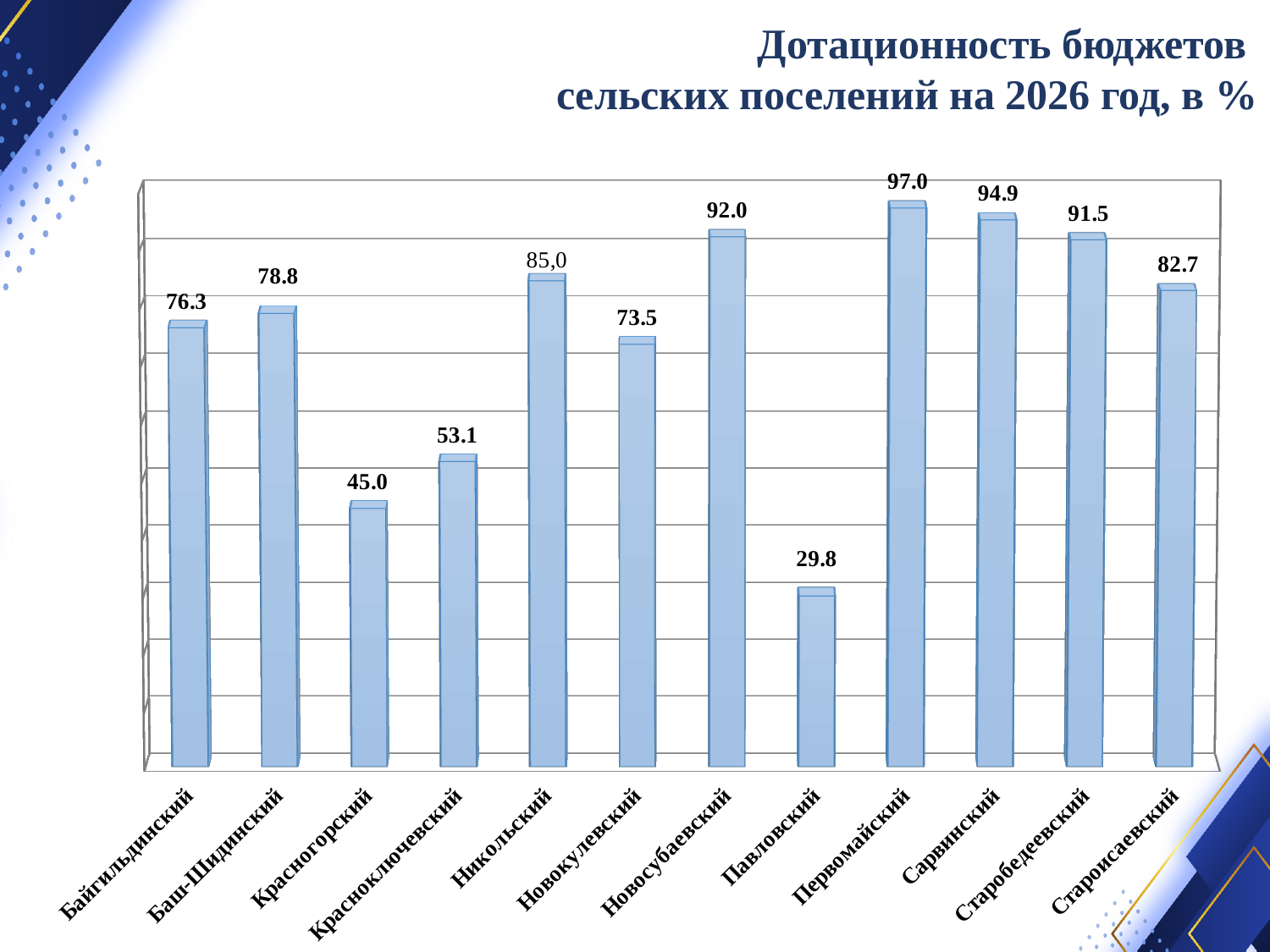
What is the value for Старобедеевский? 91.5 Which is larger, the value for Красногорский or the value for Красноключевский? Красноключевский What is the difference between the values for Новосубаевский and Новокулевский? 18.5 What kind of chart is shown on the slide? Bar chart What is the value for Никольский? 85,0 Which settlement has the lowest value? Павловский What is the difference between the values for Первомайский and Павловский? 67.2 What is the title of the chart? Дотационность бюджетов сельских поселений на 2026 год, в % How many settlements are shown on the chart? 12 Which settlement has the highest value? Первомайский What is the value for Байгильдинский? 76.3 What is the value for Павловский? 29.8